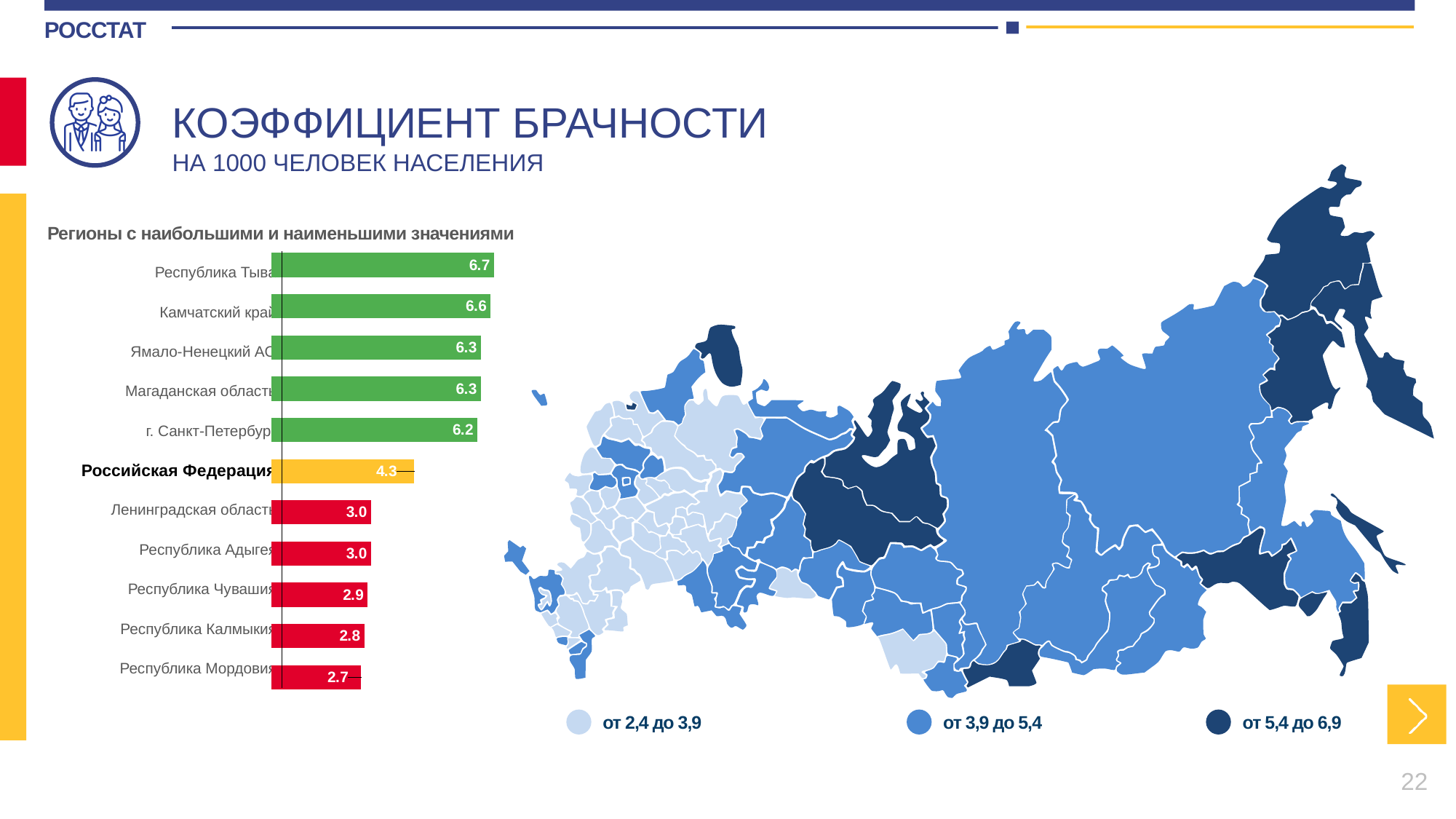
What is the difference between the values for Республика Тыва and Республика Мордовия in the bar chart? 4.0 What is the marriage rate value shown for Республика Тыва in the bar chart? 6.7 What is the value shown for Республика Мордовия in the bar chart? 2.7 Which has a larger value in the bar chart, г. Санкт-Петербург or Республика Чувашия? г. Санкт-Петербург How many value ranges does the map legend list? 3 How many regions (bars) are shown in the bar chart? 11 Which region has the lowest value in the bar chart? Республика Мордовия What value is shown for Камчатский край in the bar chart? 6.6 What value does the bar chart show for Российская Федерация? 4.3 What is the difference between the value for Российская Федерация and the value for Ленинградская область? 1.3 What type of chart is used to show the regions with the highest and lowest values? Bar chart Which region has the highest value in the bar chart? Республика Тыва